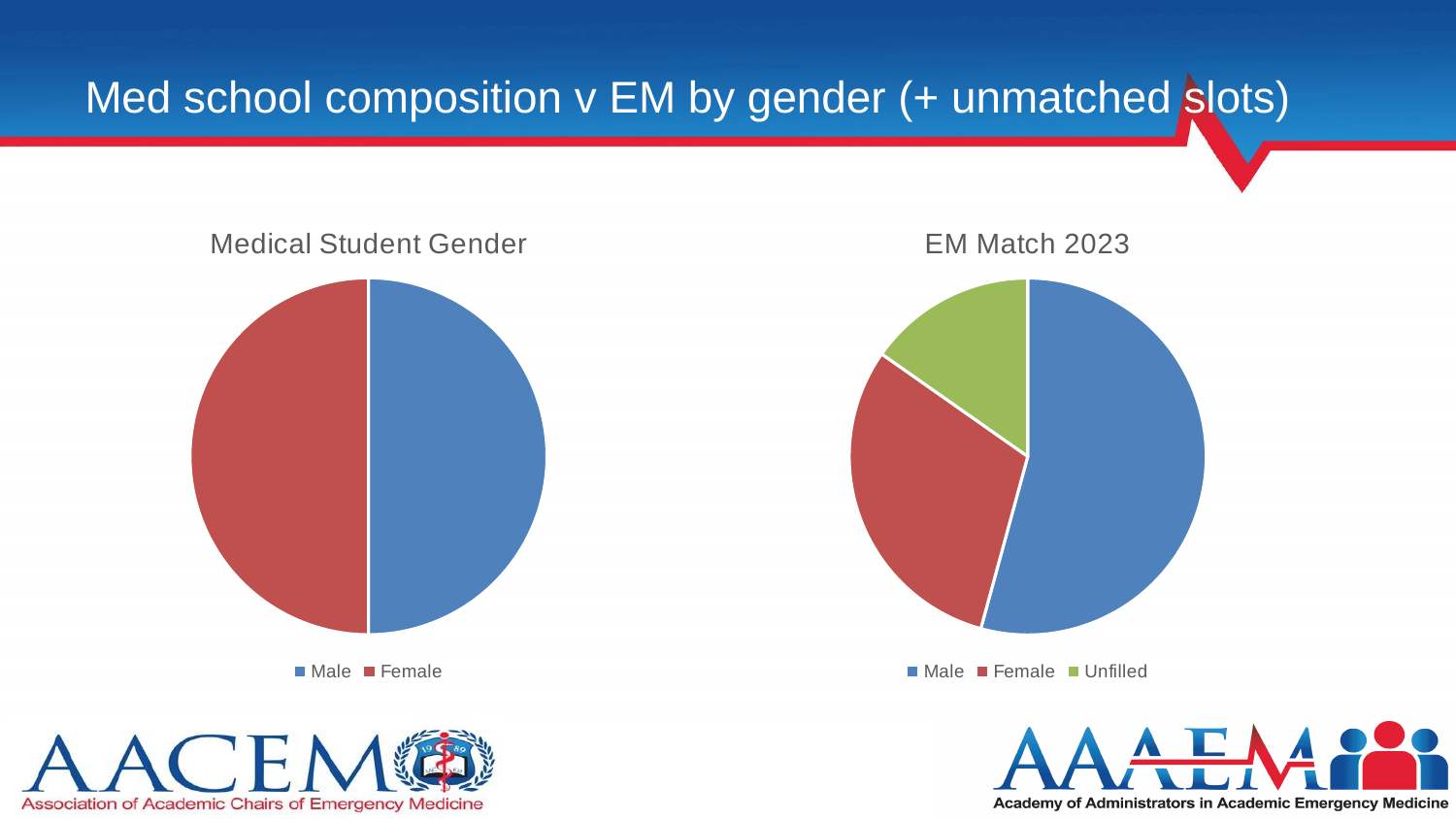
In the "EM Match 2023" chart, which category has the largest slice? Male In the "EM Match 2023" chart, which category has the smallest slice? Unfilled What is the title of the pie chart on the left of the slide? Medical Student Gender What kind of chart is the "EM Match 2023" chart? pie chart In the "EM Match 2023" chart, which slice is larger, Female or Unfilled? Female In the "EM Match 2023" chart, which slice is larger, Male or Female? Male In the "Medical Student Gender" chart, how many slices does the pie have? 2 What kind of chart is the "Medical Student Gender" chart? pie chart In the "EM Match 2023" chart, which category is shown in green? Unfilled In the "Medical Student Gender" chart, how many entries does the legend list? 2 In the "EM Match 2023" chart, how many slices does the pie have? 3 In the "EM Match 2023" chart, how many entries does the legend list? 3